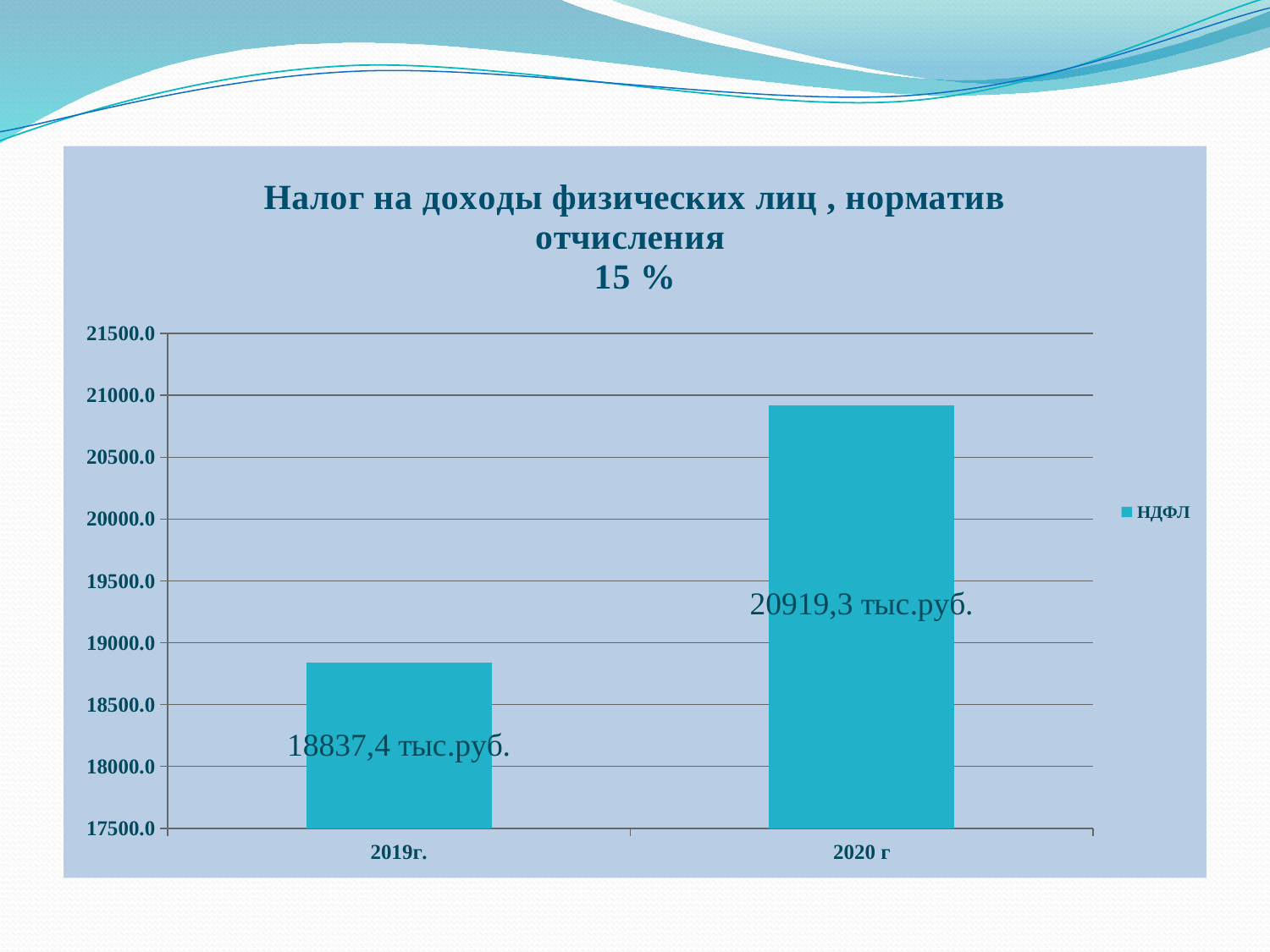
Is the value for 2019г. greater or less than 19000.0? less What is the value for 2020 г? 20919,3 тыс.руб. How many series does the legend list? 1 How many categories are shown on the x axis? 2 Which year has the lower value? 2019г. What series name is shown in the legend? НДФЛ Is the value for 2019г. larger or smaller than the value for 2020 г? smaller Which year has the higher value? 2020 г Is the value for 2020 г greater or less than 20500.0? greater What is the value for 2019г.? 18837,4 тыс.руб. What is the difference between the 2020 г value and the 2019г. value? 2081,9 тыс.руб. What kind of chart is shown on the slide? bar chart